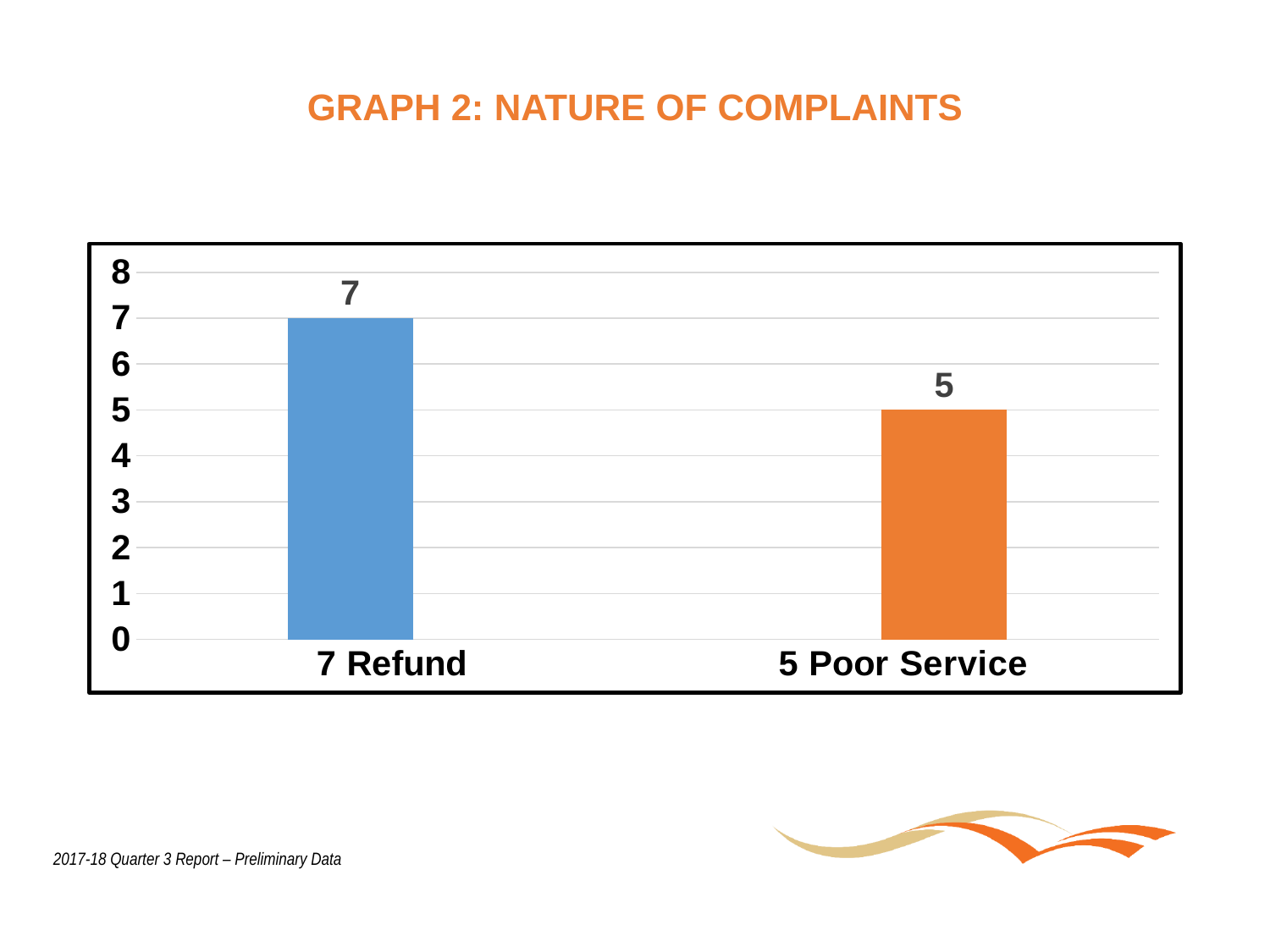
Is the value for 7 Refund greater or less than 4? greater What is the value for 5 Poor Service? 5 Which is larger, the value for 7 Refund or the value for 5 Poor Service? 7 Refund What is the title of the chart? GRAPH 2: NATURE OF COMPLAINTS Which category has the lowest value? 5 Poor Service Which category has the highest value? 7 Refund What is the difference between the values for 7 Refund and 5 Poor Service? 2 How many categories are shown on the chart? 2 Is the value for 5 Poor Service greater or less than 6? less What kind of chart is shown on the slide? bar chart What is the value for 7 Refund? 7 What colour is the bar for 5 Poor Service? orange